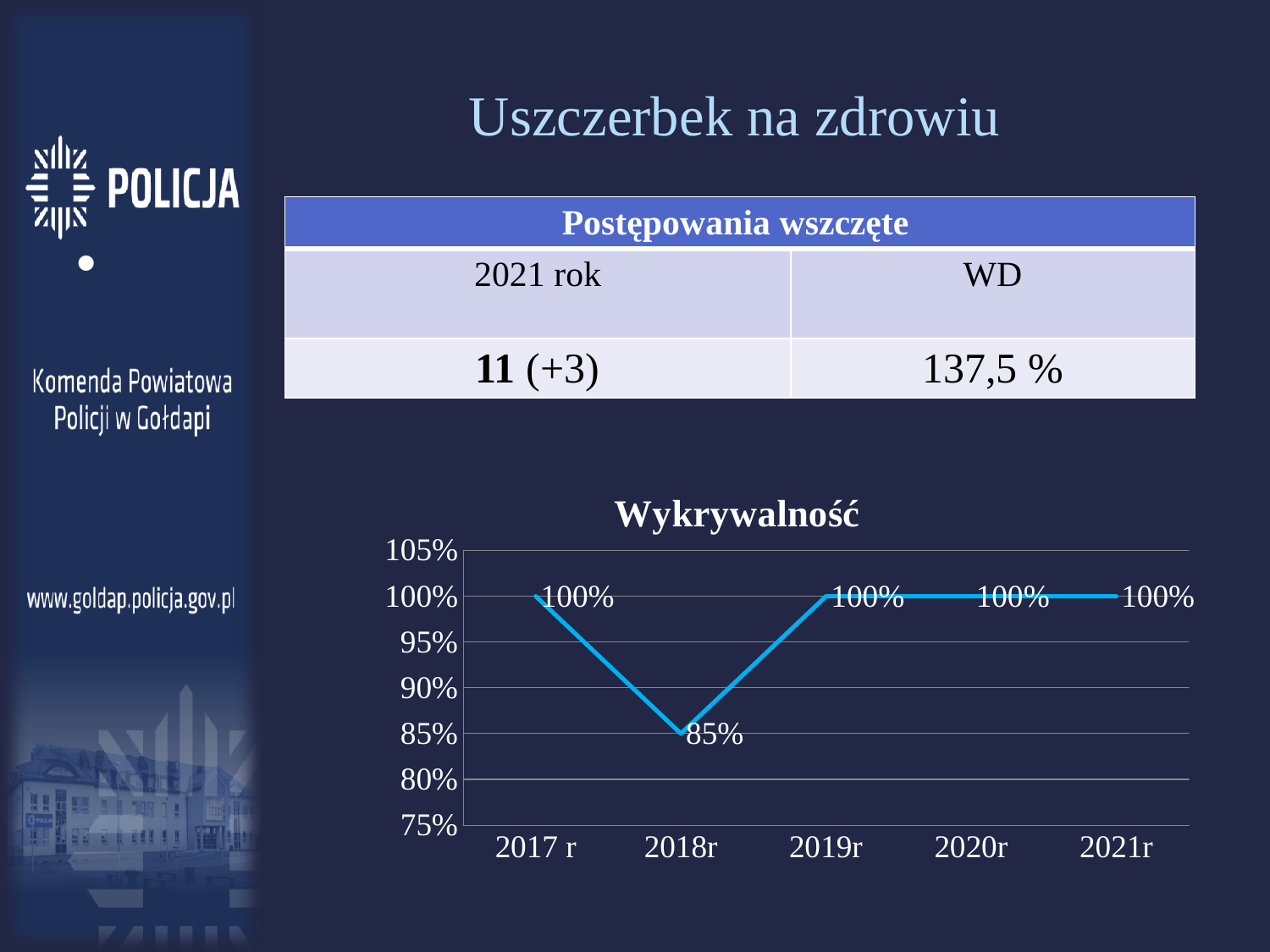
How many years are plotted on the x axis of the Wykrywalność chart? 5 What is the value for 2017 r in the Wykrywalność chart? 100% Is the value for 2018r in the Wykrywalność chart greater or less than 90%? less What kind of chart is the Wykrywalność chart? line chart Which is larger in the Wykrywalność chart, the value for 2018r or the value for 2019r? 2019r Does the value in the Wykrywalność chart rise or fall from 2018r to 2019r? rise What is the value for 2018r in the Wykrywalność chart? 85% What is the value for 2021r in the Wykrywalność chart? 100% What is the difference between the values for 2017 r and 2018r in the Wykrywalność chart? 15% What is the highest value shown on the y axis of the Wykrywalność chart? 105% Which year has the lowest value in the Wykrywalność chart? 2018r What is the title of the chart on the slide? Wykrywalność